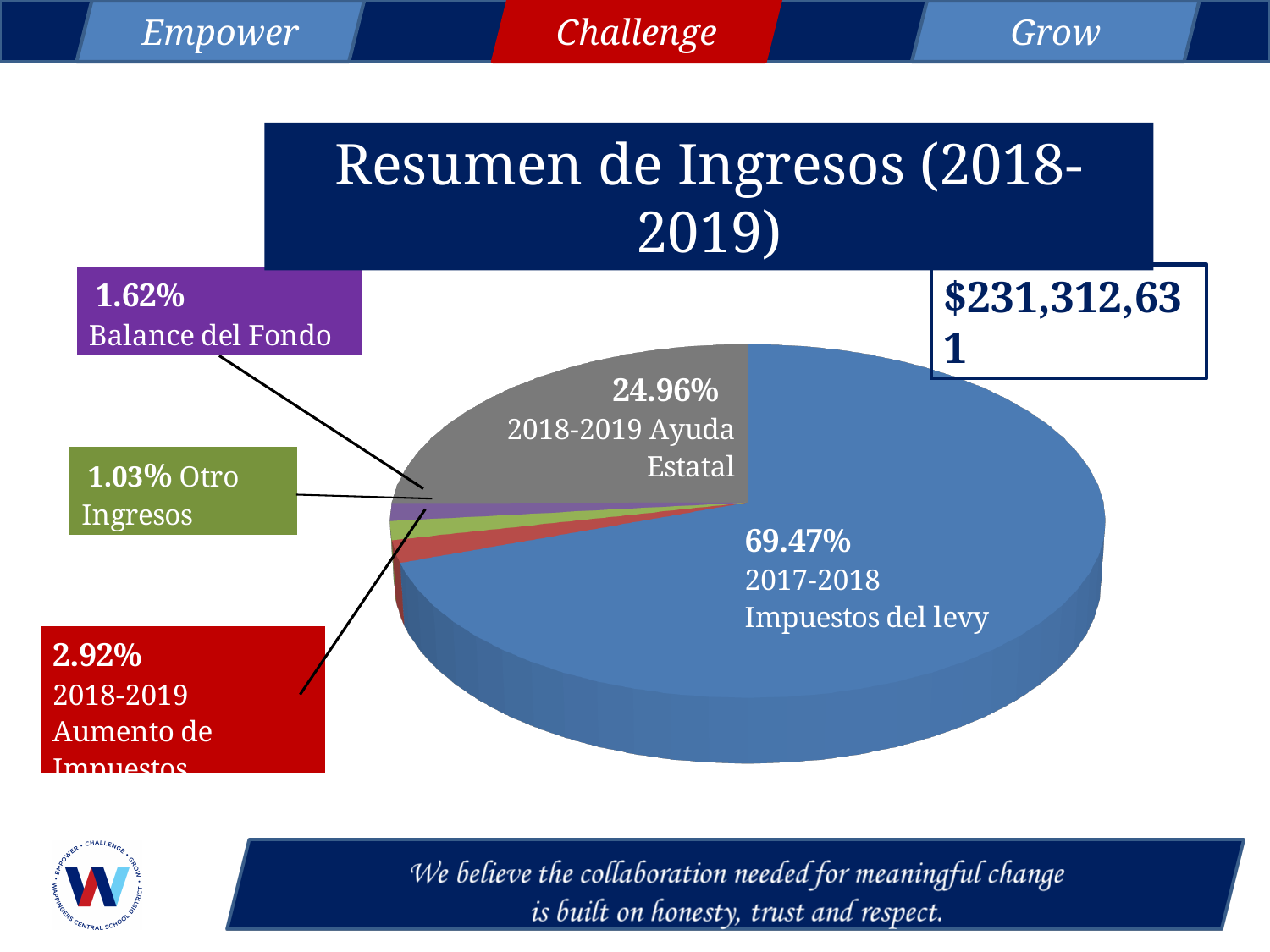
What share of the pie is 2017-2018 Impuestos del levy? 69.47% Which category has the smallest slice of the pie? Otro Ingresos What share of the pie is Balance del Fondo? 1.62% What share of the pie is 2018-2019 Aumento de Impuestos? 2.92% What is the difference in percentage points between 2017-2018 Impuestos del levy and 2018-2019 Ayuda Estatal? 44.51 Which is larger, the share for Balance del Fondo or the share for Otro Ingresos? Balance del Fondo What is the title of the chart? Resumen de Ingresos (2018-2019) How many slices does the pie chart have? 5 Which category has the largest slice of the pie? 2017-2018 Impuestos del levy What kind of chart is shown on the slide? pie chart